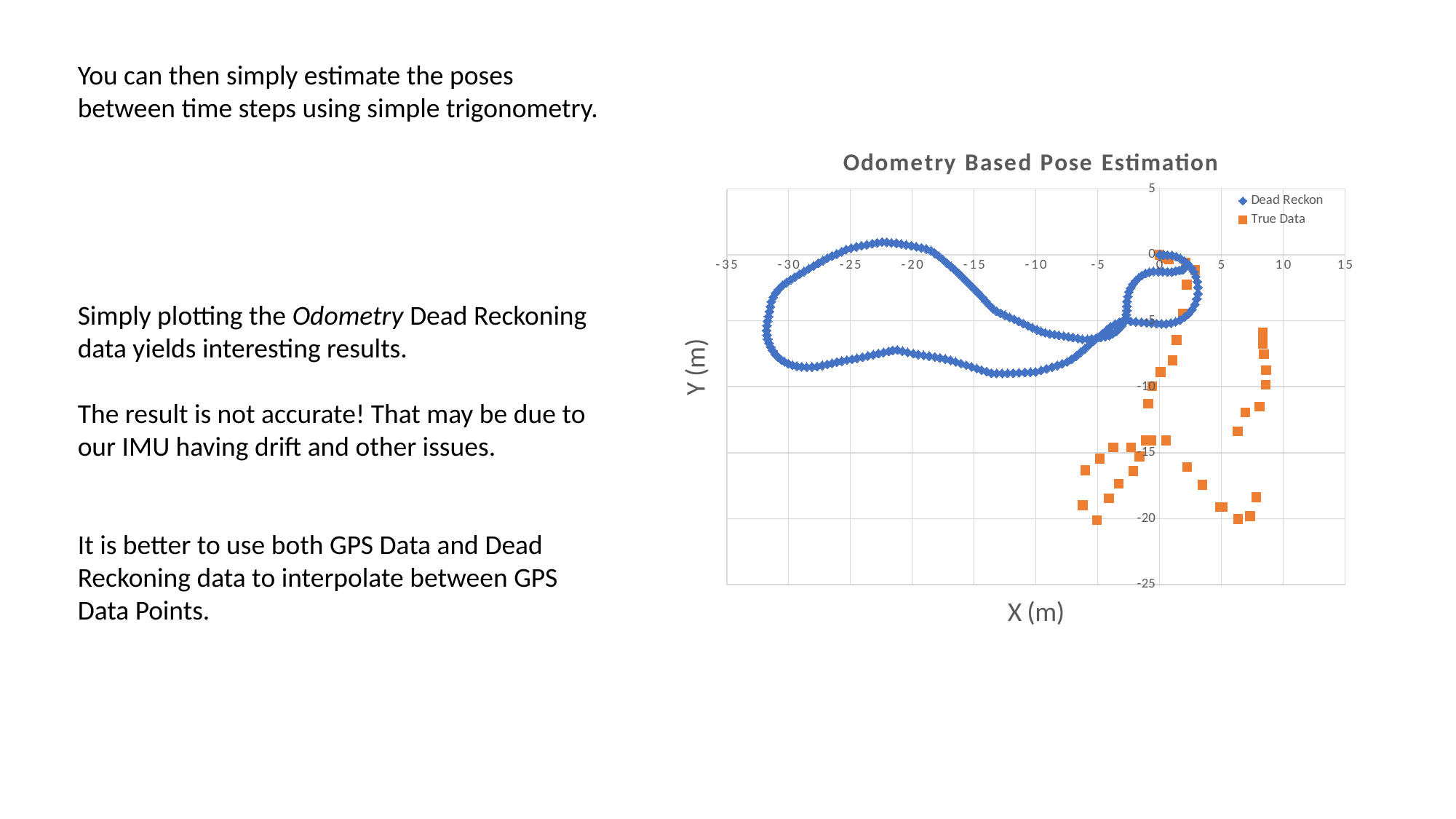
What are the two series named in the chart legend? Dead Reckon and True Data Which series in the chart extends furthest to the left (most negative X)? Dead Reckon Is the most negative X value reached by the True Data series greater or less than -10? greater Is the lowest Y value reached by the Dead Reckon series greater or less than -10? greater Is the lowest Y value reached by the True Data series greater or less than -15? less What is the title of the chart? Odometry Based Pose Estimation Which series in the chart reaches the lowest Y value? True Data How many series does the legend of the chart list? 2 What kind of chart is shown on the slide? scatter chart